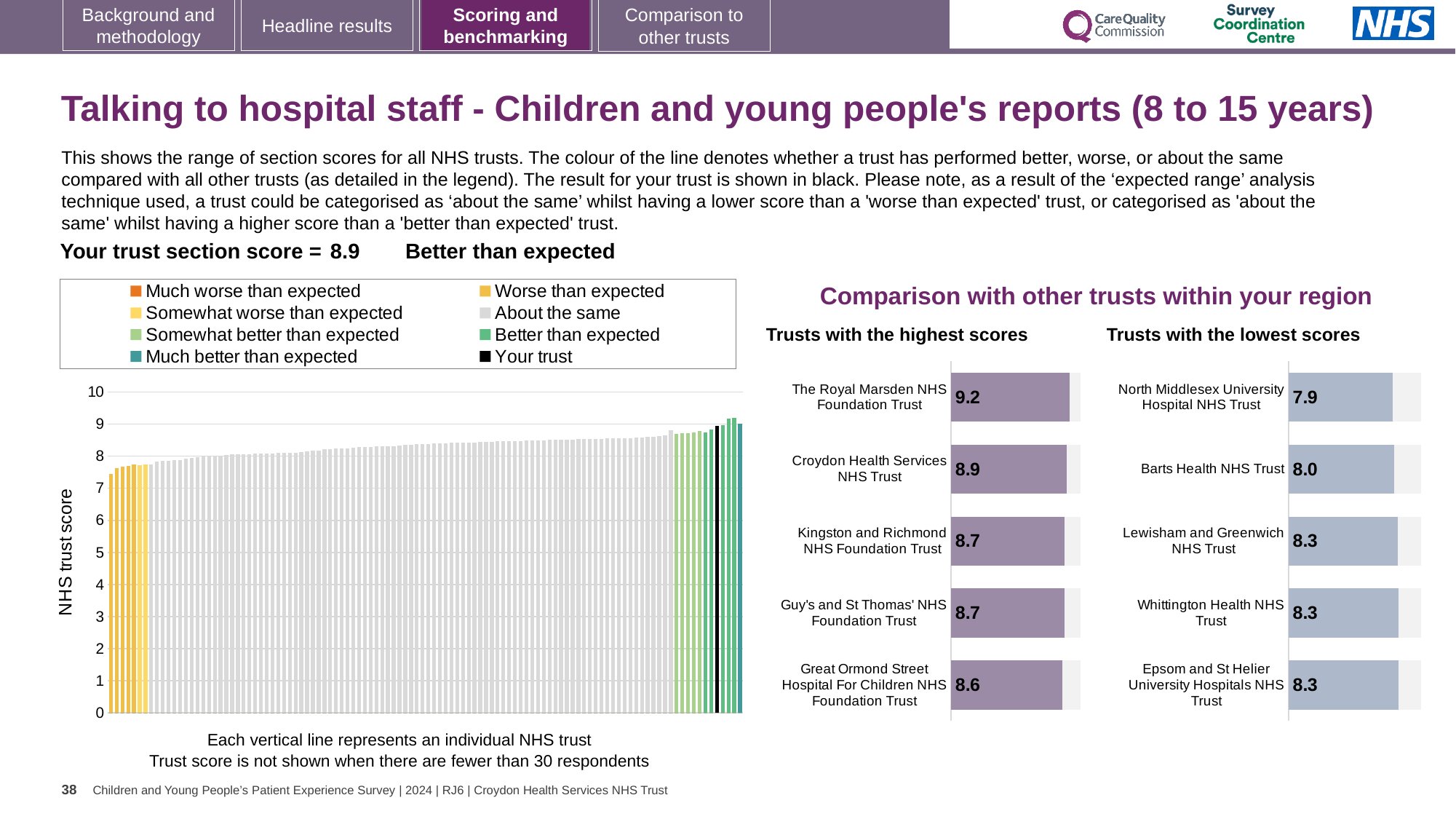
In the 'Trusts with the lowest scores' chart, what is the score for Barts Health NHS Trust? 8.0 In the 'Trusts with the highest scores' chart, what is the difference between the scores of The Royal Marsden NHS Foundation Trust and Great Ormond Street Hospital For Children NHS Foundation Trust? 0.6 In the large 'NHS trust score' chart on the left, is the value for the lowest-scoring trust greater or less than 8? less In the 'Trusts with the lowest scores' chart, which has the larger score: Barts Health NHS Trust or North Middlesex University Hospital NHS Trust? Barts Health NHS Trust In the 'Trusts with the highest scores' chart, which trust has the highest score? The Royal Marsden NHS Foundation Trust How many trusts are shown in the 'Trusts with the highest scores' chart? 5 How many entries does the legend of the large 'NHS trust score' chart on the left list? 8 In the 'Trusts with the lowest scores' chart, which trust has the lowest score? North Middlesex University Hospital NHS Trust In the 'Trusts with the highest scores' chart, what is the score for Great Ormond Street Hospital For Children NHS Foundation Trust? 8.6 In the large 'NHS trust score' chart on the left, do the trust scores rise or fall from left to right? rise In the 'Trusts with the lowest scores' chart, what is the score for North Middlesex University Hospital NHS Trust? 7.9 In the 'Trusts with the highest scores' chart, what is the score for The Royal Marsden NHS Foundation Trust? 9.2